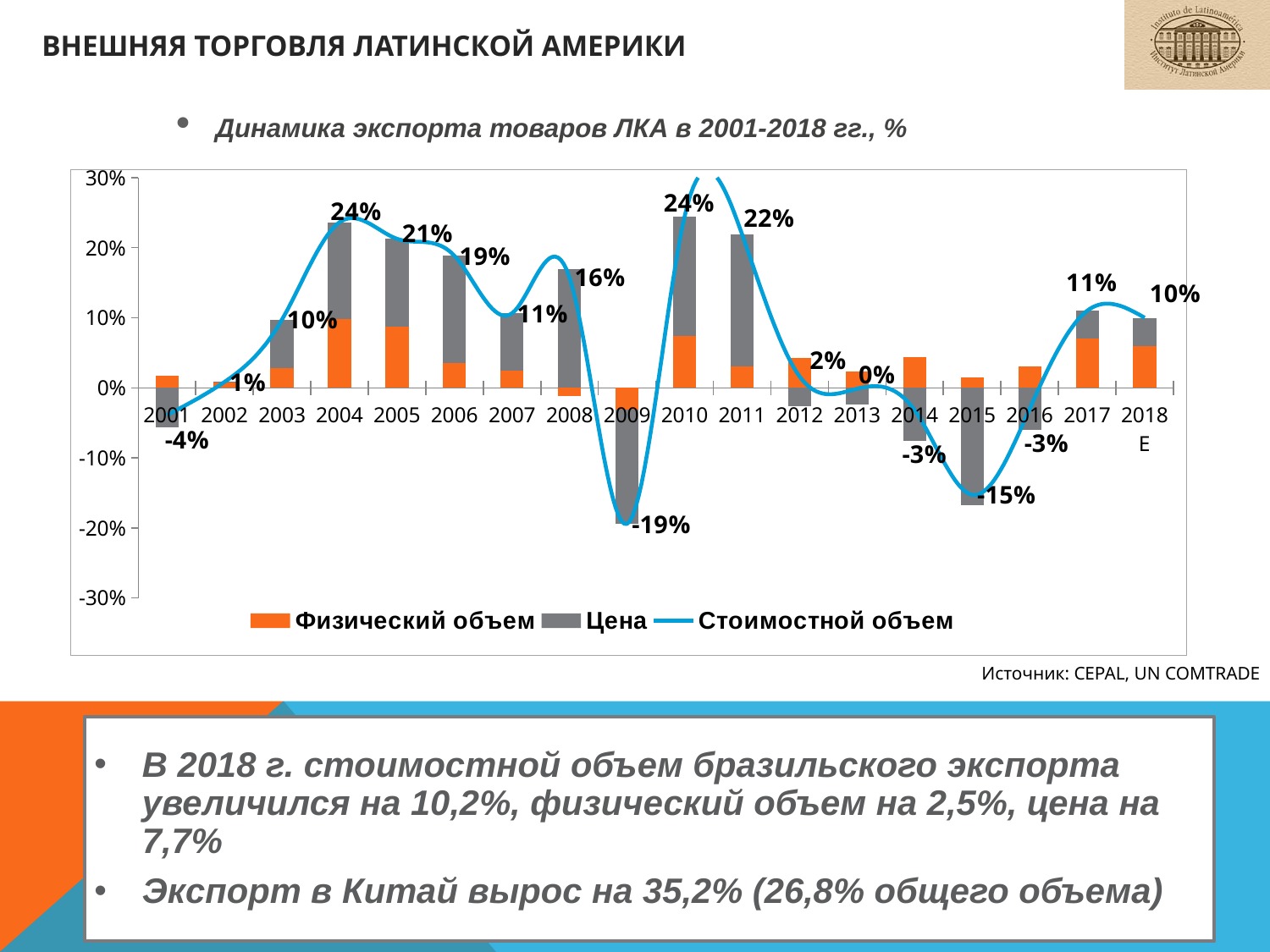
What is the value of Стоимостной объем for 2015? -15% How many years are shown on the x axis? 18 What is the value of Стоимостной объем for 2009? -19% Is the Цена (grey) bar segment for 2011 greater or less than 10%? greater Which is larger, the Стоимостной объем value for 2005 or for 2006? 2005 What is the value of Стоимостной объем for 2018? 10% What is the value of Стоимостной объем for 2004? 24% How many series does the legend list? 3 What kind of chart is shown? Combined stacked bar and line chart Which year has the lowest value of Стоимостной объем? 2009 Does the Стоимостной объем value rise or fall from 2016 to 2017? rise What is the difference between the Стоимостной объем values for 2011 and 2012? 20%